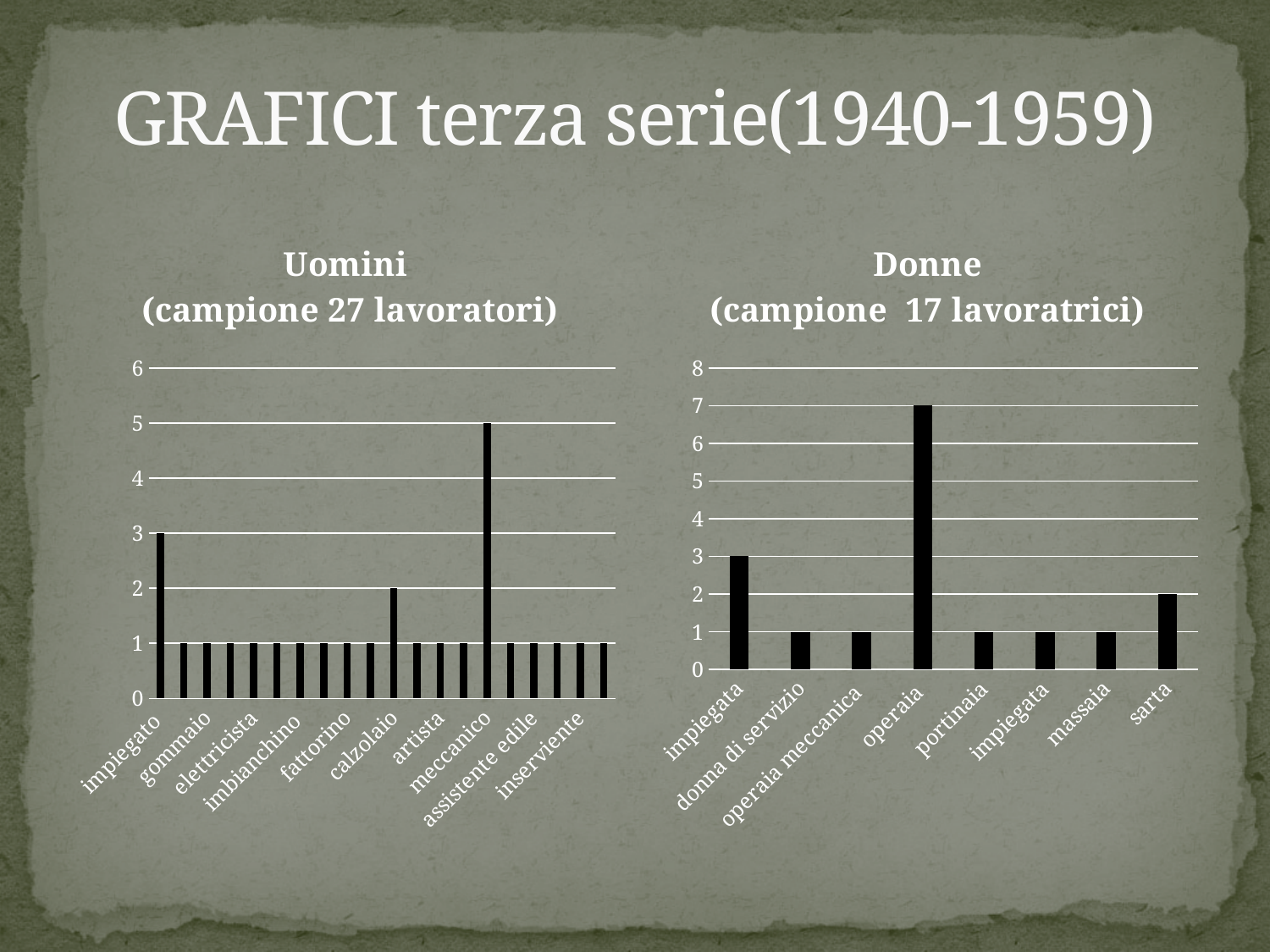
In the 'Uomini (campione 27 lavoratori)' chart, what is the difference between the values for meccanico and calzolaio? 3 In the 'Uomini (campione 27 lavoratori)' chart, what is the value for calzolaio? 2 In the 'Donne (campione 17 lavoratrici)' chart, what is the value for operaia? 7 In the 'Donne (campione 17 lavoratrici)' chart, what is the value for massaia? 1 How many categories are shown in the 'Donne (campione 17 lavoratrici)' chart? 8 In the 'Donne (campione 17 lavoratrici)' chart, which is larger, the value for operaia or the value for sarta? operaia What kind of chart is the 'Uomini (campione 27 lavoratori)' chart? bar chart In the 'Donne (campione 17 lavoratrici)' chart, what is the value for sarta? 2 In the 'Uomini (campione 27 lavoratori)' chart, which category has the highest value? meccanico In the 'Uomini (campione 27 lavoratori)' chart, what is the value for impiegato? 3 In the 'Donne (campione 17 lavoratrici)' chart, which category has the highest value? operaia In the 'Uomini (campione 27 lavoratori)' chart, what is the value for meccanico? 5